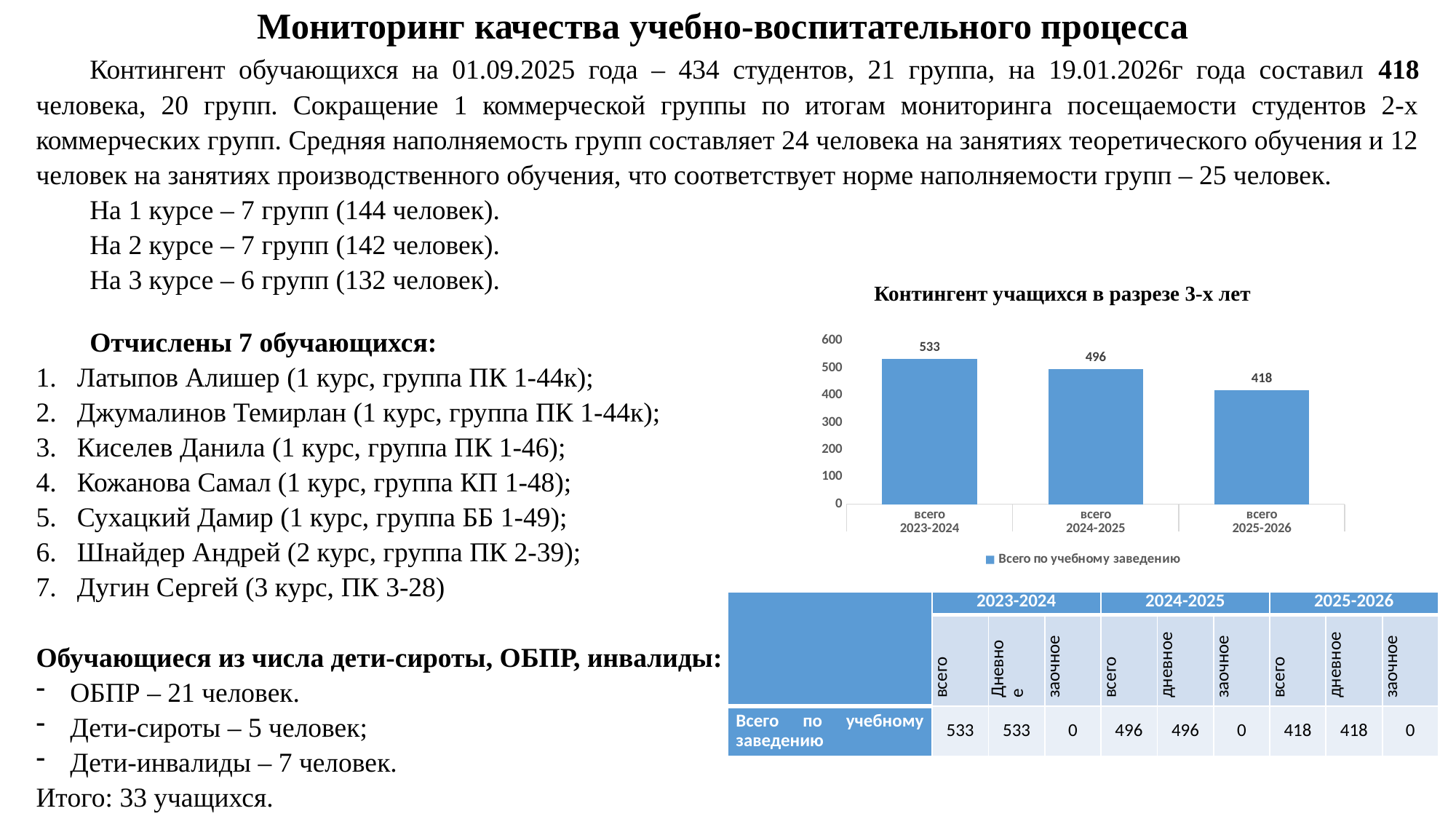
What kind of chart is shown on the slide? bar chart Is the value for всего 2025-2026 greater or less than 500? less What is the value for всего 2023-2024 in the chart? 533 Which is larger, the value for всего 2023-2024 or всего 2024-2025? всего 2023-2024 Which category has the lowest value in the chart? всего 2025-2026 Which category has the highest value in the chart? всего 2023-2024 What is the difference between the values for всего 2024-2025 and всего 2025-2026? 78 How many bars are shown in the chart? 3 What is the value for всего 2025-2026 in the chart? 418 Do the values rise or fall from left to right along the x axis? fall What is the difference between the values for всего 2023-2024 and всего 2025-2026? 115 What is the value for всего 2024-2025 in the chart? 496